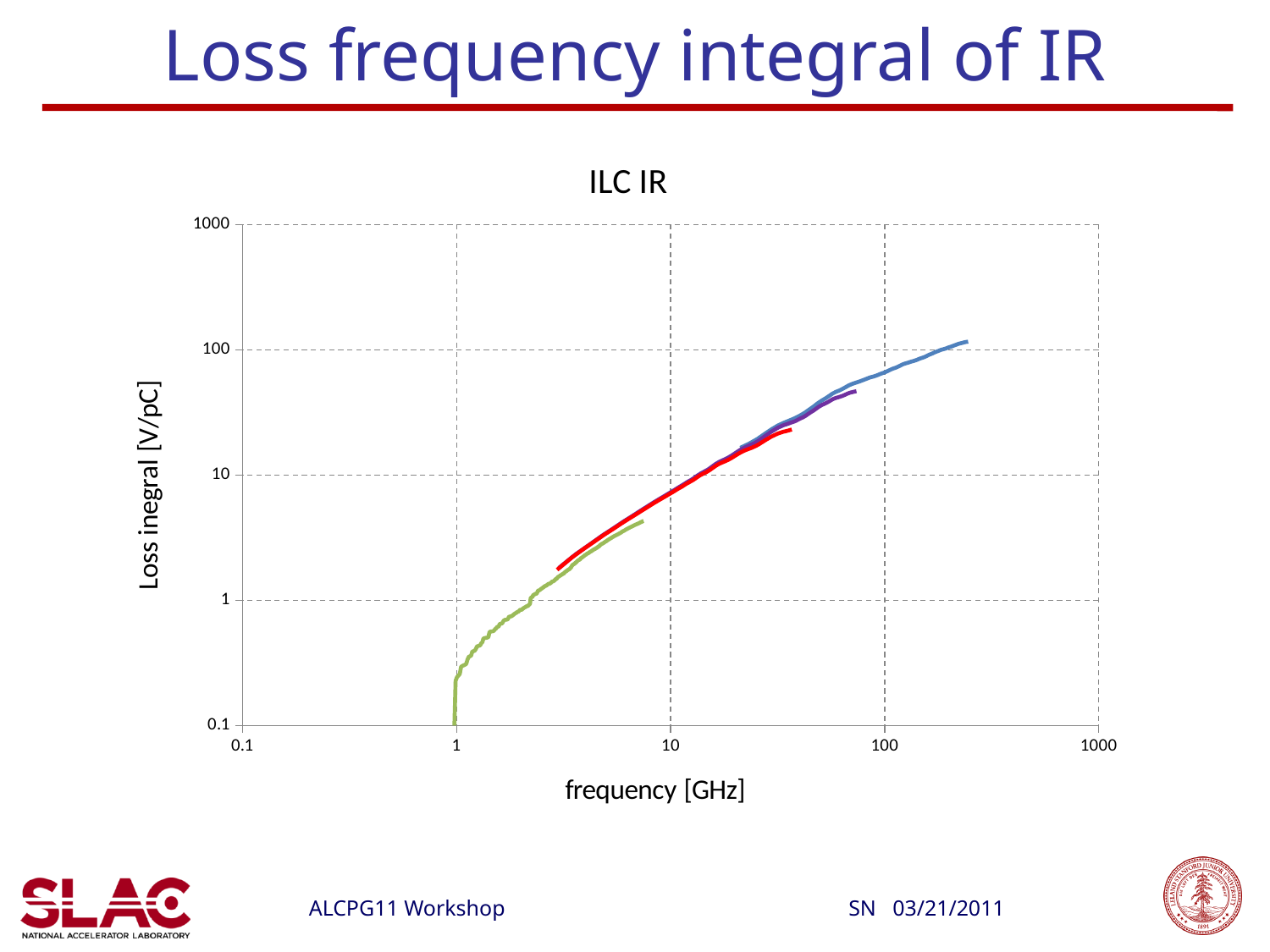
How many lines are plotted on the chart? 4 Is the value of the green line at 1 GHz greater or less than 1? less Is the value of the blue line at 100 GHz greater or less than 10? greater Do the plotted values rise or fall as frequency increases along the x axis? rise What is the label of the x axis of the chart? frequency [GHz] What kind of chart is shown on the slide? line chart What is the title of the chart? ILC IR Is the value of the blue line at 100 GHz greater or less than 100? less Which line reaches the highest frequency on the chart, the green line or the blue line? blue line